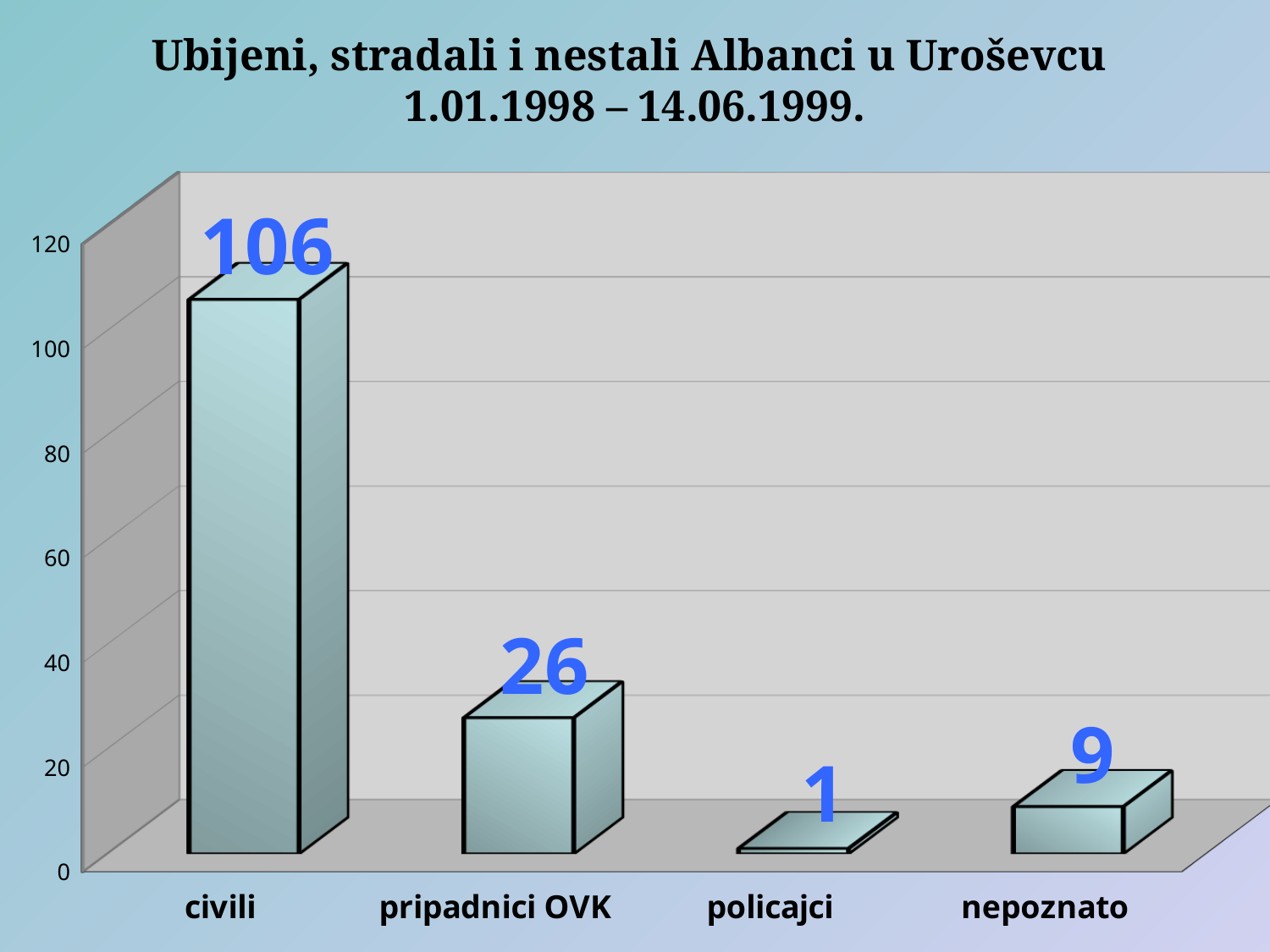
What is the value for nepoznato? 9 What is the title of the chart? Ubijeni, stradali i nestali Albanci u Uroševcu 1.01.1998 – 14.06.1999. Which is larger, the value for pripadnici OVK or the value for nepoznato? pripadnici OVK What kind of chart is shown on the slide? bar chart What is the difference between the values for nepoznato and policajci? 8 What is the value for policajci? 1 What is the difference between the values for civili and pripadnici OVK? 80 How many categories are shown on the x axis? 4 What is the value for pripadnici OVK? 26 Which category has the highest value? civili What is the value for civili? 106 Which category has the lowest value? policajci